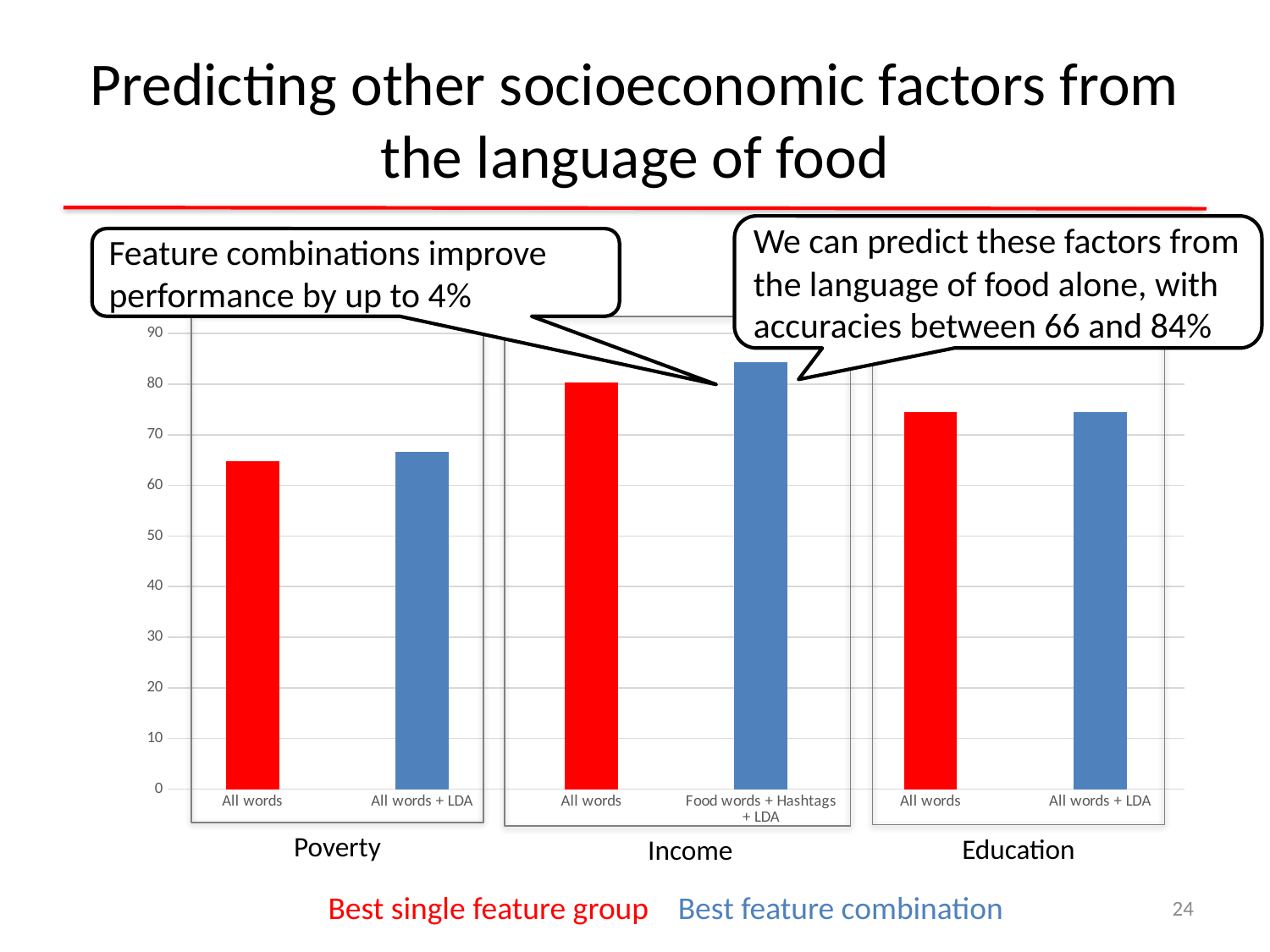
What do the blue bars represent according to the legend below the chart? Best feature combination What kind of chart is shown on the slide? bar chart Which bar is the tallest in the chart? Food words + Hashtags + LDA (Income) How many bars are plotted in the chart in total? 6 Is the value for All words in the Education group greater or less than 70? greater Is the value for All words in the Poverty group greater or less than 70? less In the Income group, which is larger: All words or Food words + Hashtags + LDA? Food words + Hashtags + LDA Is the value for Food words + Hashtags + LDA in the Income group greater or less than 80? greater How many socioeconomic factor groups (panels) does the chart show? 3 What do the red bars represent according to the legend below the chart? Best single feature group